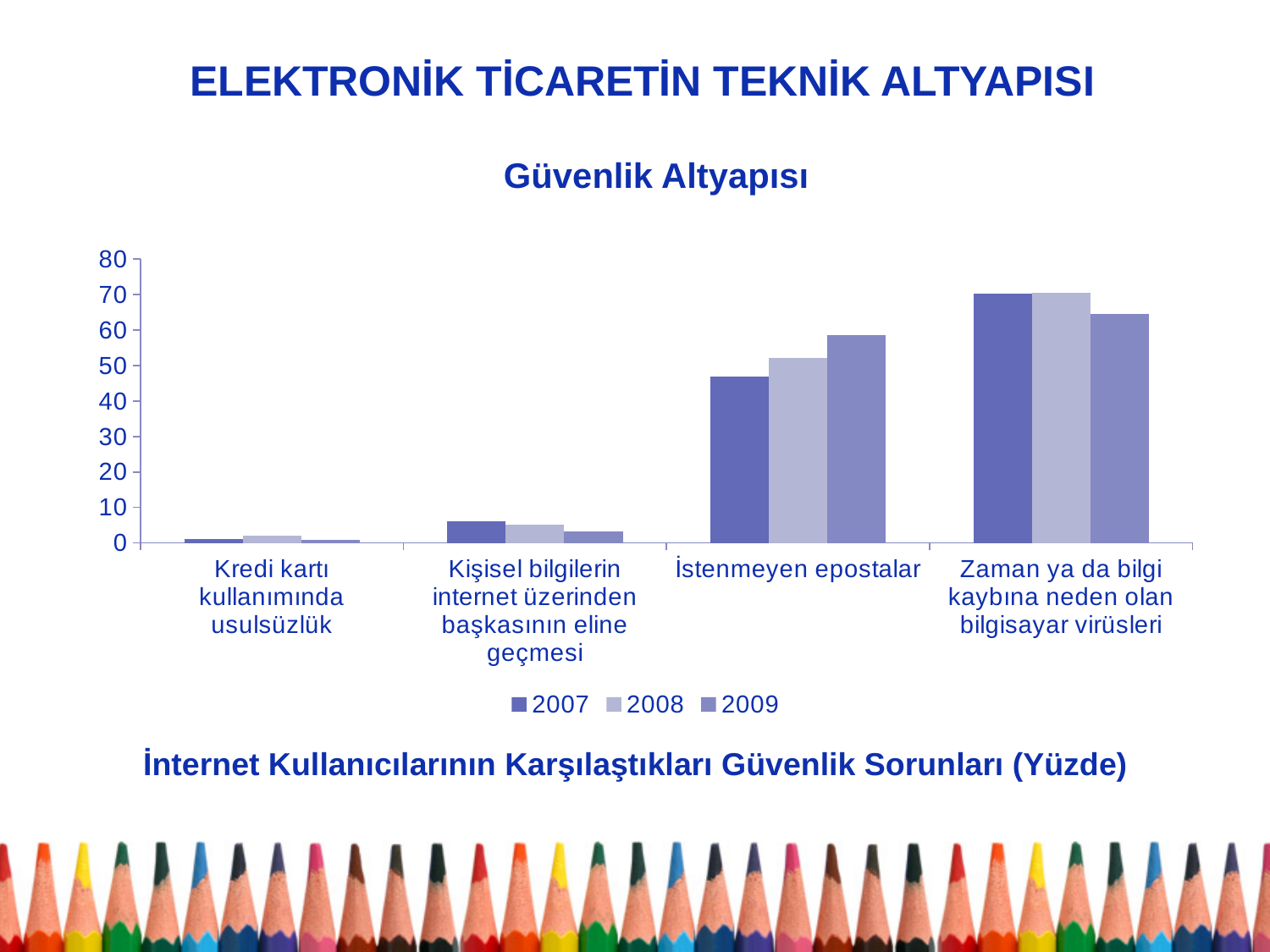
Is the 2009 value for İstenmeyen epostalar greater or less than 50? greater What kind of chart is shown on the slide? bar chart For İstenmeyen epostalar, which is larger: the 2007 value or the 2009 value? 2009 How many series does the chart's legend list? 3 Is the 2009 value for Zaman ya da bilgi kaybına neden olan bilgisayar virüsleri greater or less than 60? greater Which category has the lowest bars in the chart? Kredi kartı kullanımında usulsüzlük Is the 2007 value for Kişisel bilgilerin internet üzerinden başkasının eline geçmesi greater or less than 10? less Which category has the highest bars in the chart? Zaman ya da bilgi kaybına neden olan bilgisayar virüsleri For İstenmeyen epostalar, do the values rise or fall from 2007 to 2009? rise Which years are listed in the chart's legend? 2007, 2008, 2009 How many categories are shown on the x axis of the chart? 4